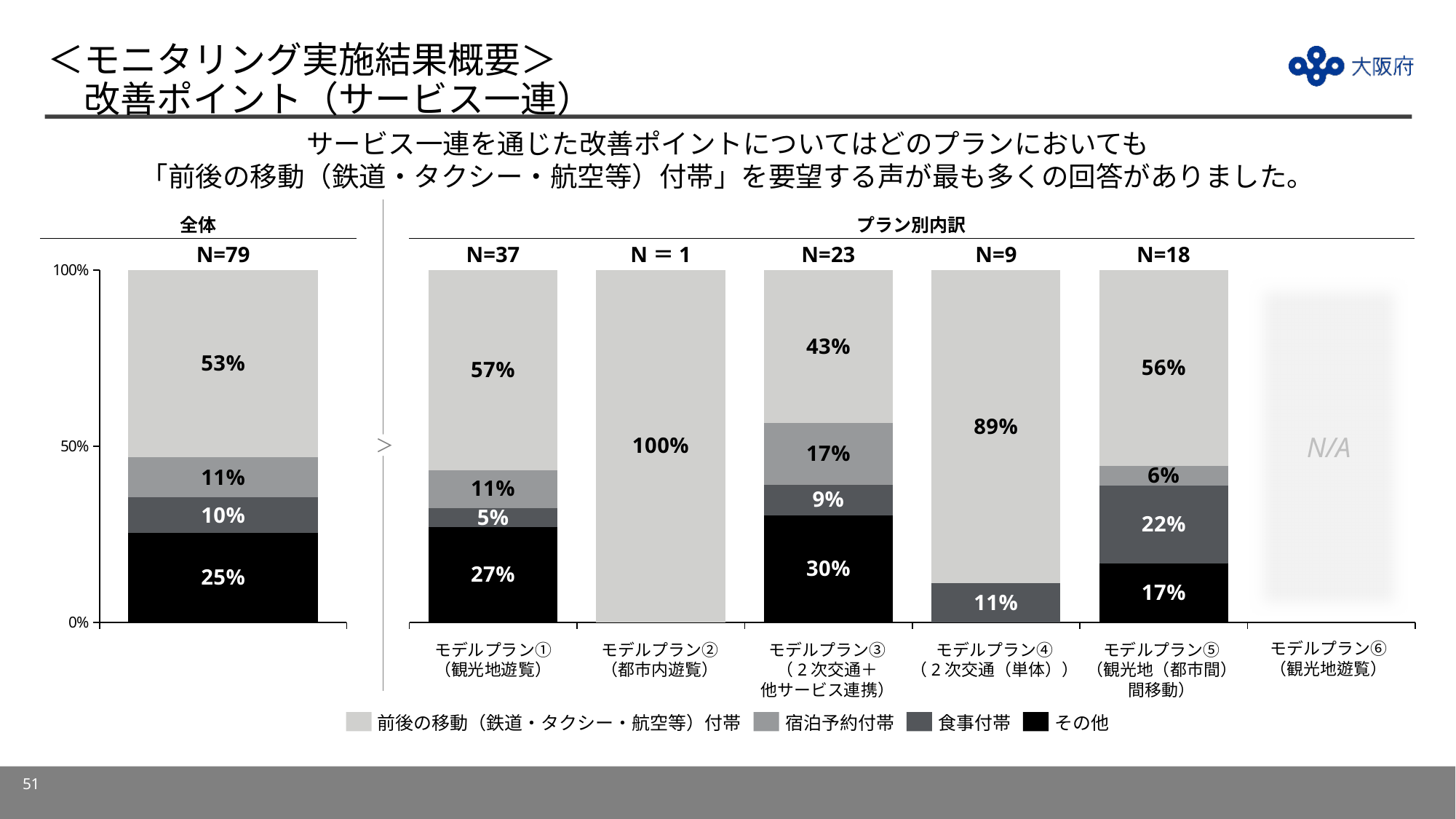
What is the sample size (N) shown above the 全体 chart? N=79 In the 全体 chart, what is the value for 前後の移動（鉄道・タクシー・航空等）付帯? 53% In the 全体 chart, is the value for 前後の移動（鉄道・タクシー・航空等）付帯 greater or less than 50%? greater How many series does the legend list? 4 In the プラン別内訳 chart, what is the value for 前後の移動（鉄道・タクシー・航空等）付帯 in モデルプラン③? 43% In the プラン別内訳 chart, what is the value for 食事付帯 in モデルプラン⑤? 22% In the プラン別内訳 chart, which model plan has the highest value for 前後の移動（鉄道・タクシー・航空等）付帯? モデルプラン② In the プラン別内訳 chart, what is the difference between the その他 values for モデルプラン③ and モデルプラン⑤? 13% In the 全体 chart, what is the value for その他? 25% In the プラン別内訳 chart, which model plan has the lowest value for 前後の移動（鉄道・タクシー・航空等）付帯 among those with data? モデルプラン③ What kind of chart is the プラン別内訳 chart? Stacked bar chart In the プラン別内訳 chart, which is larger: 宿泊予約付帯 in モデルプラン① or in モデルプラン⑤? モデルプラン①